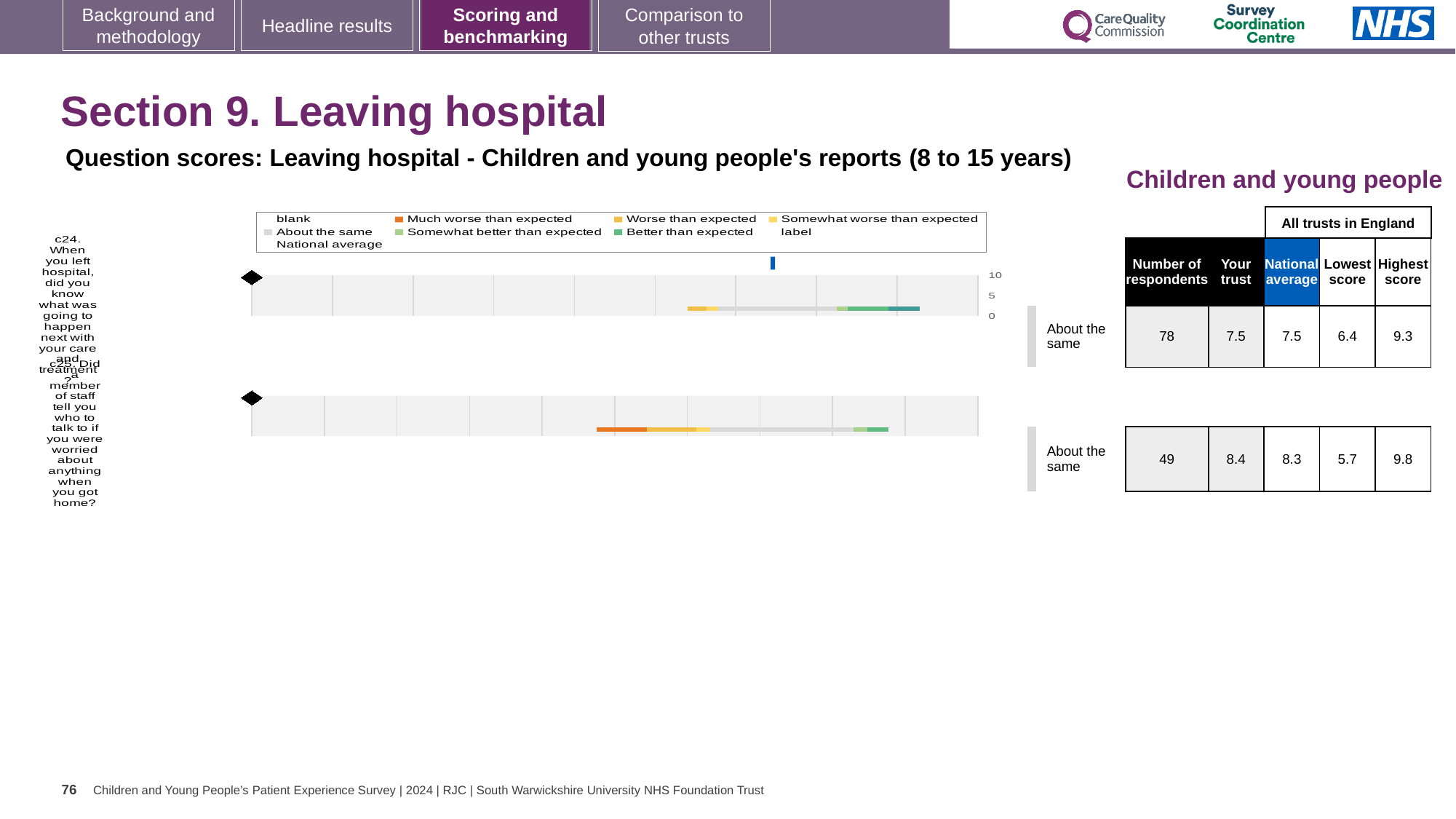
What is the 'Your trust' score for question c25 (Did a member of staff tell you who to talk to if you were worried about anything when you got home?)? 8.4 How many respondents answered question c24? 78 What is the 'Your trust' score for question c24 (When you left hospital, did you know what was going to happen next with your care and treatment?)? 7.5 Which question has the higher 'Your trust' score, c24 or c25? c25 What kind of chart is used to show the question scores on this slide? bar chart What is the lowest score among all trusts in England for question c24? 6.4 How many survey questions are plotted in the chart? 2 What is the national average score for question c25? 8.3 What benchmark category is shown for question c24? About the same How many more respondents answered question c24 than question c25? 29 What is the difference between the highest and lowest scores for question c25? 4.1 What is the highest score among all trusts in England for question c25? 9.8